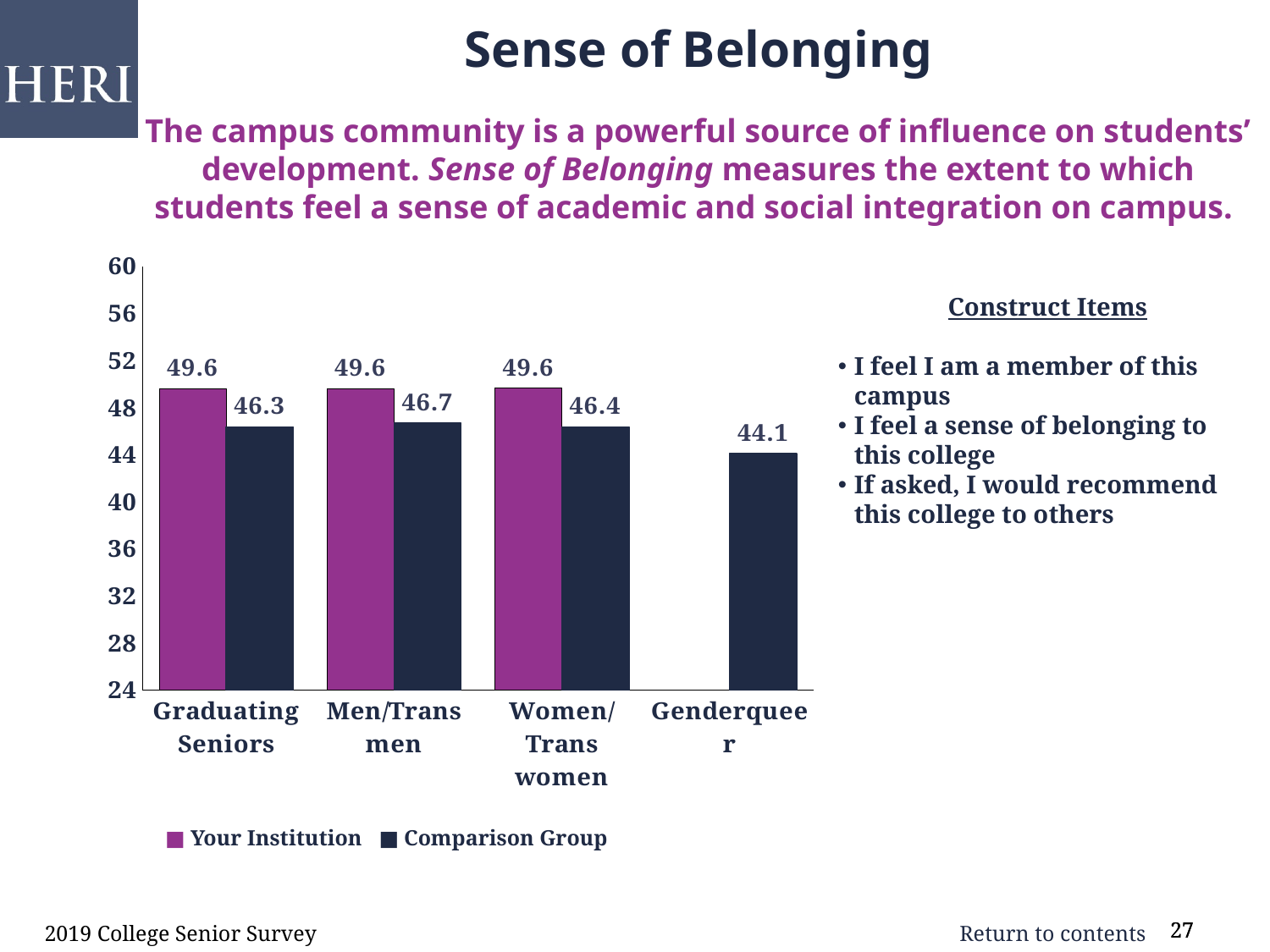
Which category has the highest Comparison Group value? Men/Trans men What is the difference between the Your Institution and Comparison Group values for Graduating Seniors? 3.3 What is the Comparison Group value for Men/Trans men? 46.7 Is the Comparison Group value for Genderqueer greater or less than 48? less What is the Your Institution value for Graduating Seniors? 49.6 How many series does the legend list? 2 Which is larger for Women/Trans women: the Your Institution value or the Comparison Group value? Your Institution Which category has the lowest Comparison Group value? Genderqueer What is the Comparison Group value for Genderqueer? 44.1 How many categories are shown on the x axis? 4 What kind of chart is shown on the slide? bar chart What is the Comparison Group value for Women/Trans women? 46.4